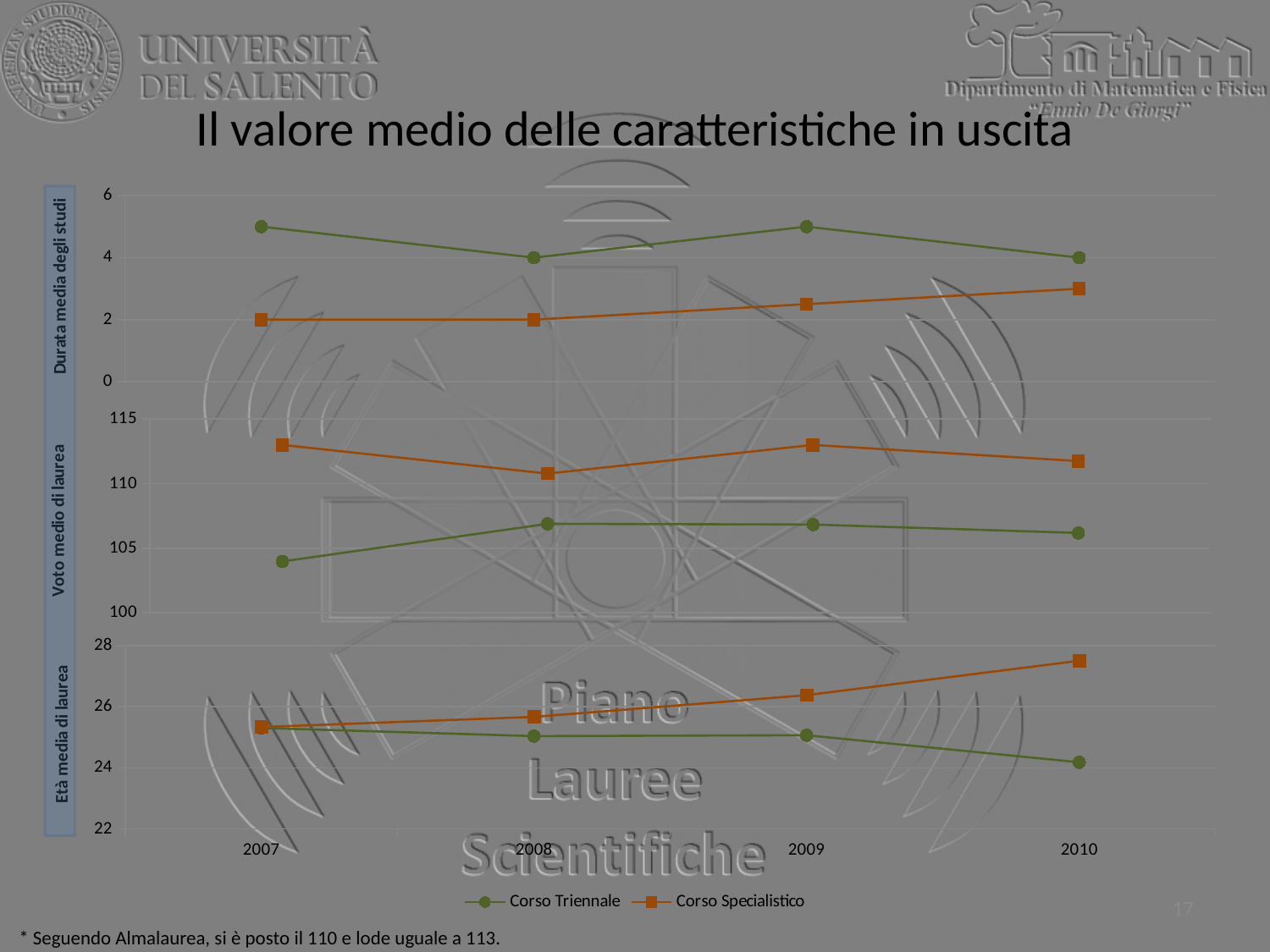
In the bottom chart (Età media di laurea), does the Corso Specialistico line rise or fall from 2007 to 2010? rise In the top chart (Durata media degli studi), in which year is the value for Corso Specialistico highest? 2010 How many years are shown on the x axis? 4 How many series does the legend list? 2 In the bottom chart (Età media di laurea), is the value for Corso Specialistico in 2010 greater or less than 26? greater In the top chart (Durata media degli studi), which series has the larger value in 2007, Corso Triennale or Corso Specialistico? Corso Triennale In the top chart (Durata media degli studi), what is the value for Corso Specialistico in 2007? 2 In the middle chart (Voto medio di laurea), is the value for Corso Specialistico in 2007 greater or less than 110? greater In the top chart (Durata media degli studi), what is the value for Corso Triennale in 2008? 4 In the middle chart (Voto medio di laurea), is the value for Corso Triennale in 2007 greater or less than 105? less What kind of chart is used on this slide? line chart In the bottom chart (Età media di laurea), in which year is the value for Corso Triennale lowest? 2010